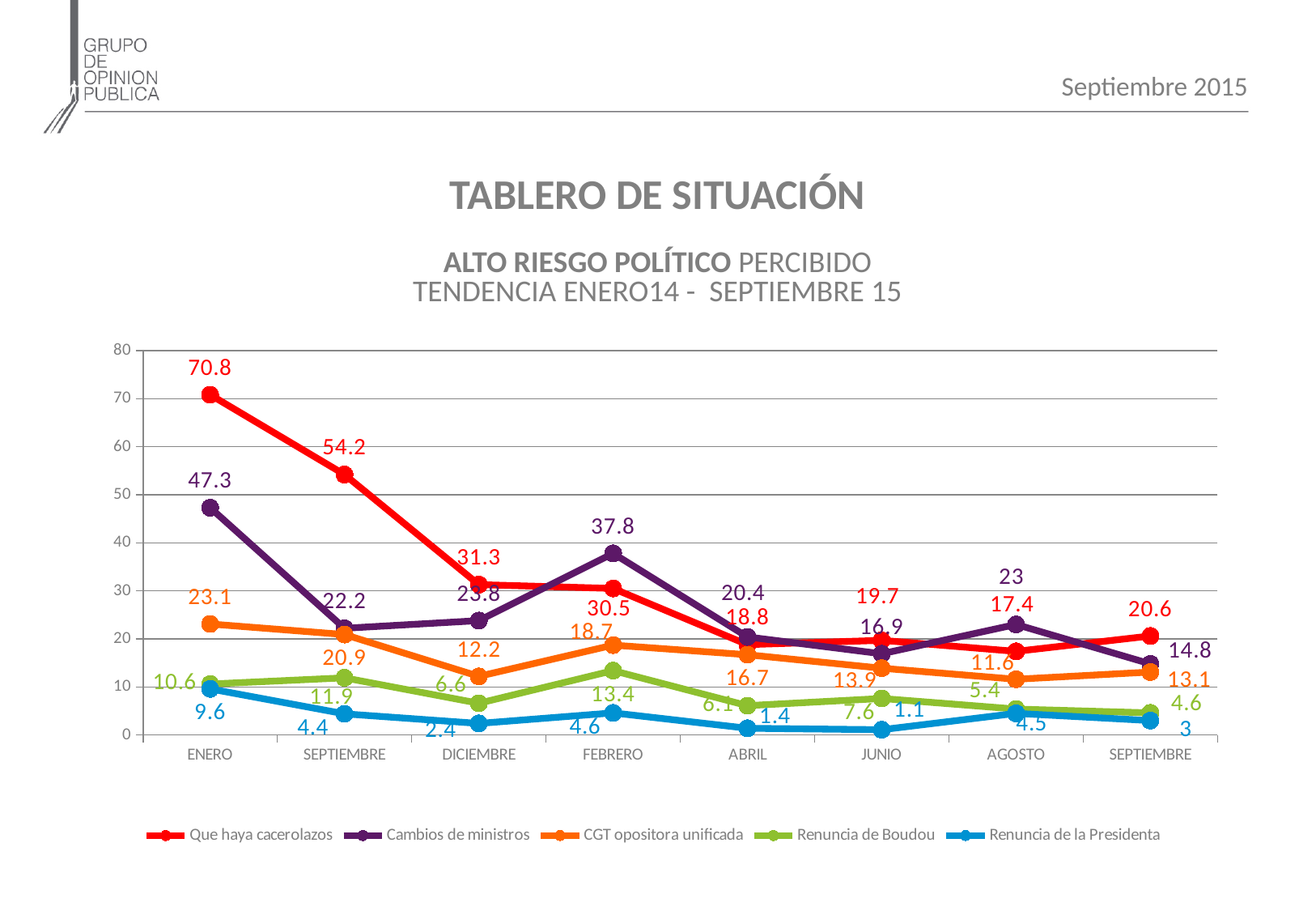
What is the value for Renuncia de Boudou at ABRIL? 6.1 What is the value for Cambios de ministros at FEBRERO? 37.8 At FEBRERO, which is larger: Cambios de ministros or Que haya cacerolazos? Cambios de ministros At which x-axis category does Renuncia de la Presidenta reach its lowest value? JUNIO How many categories are shown on the x axis? 8 How many series does the legend list? 5 Does the Que haya cacerolazos line rise or fall from ENERO to DICIEMBRE? Fall What kind of chart is shown on the slide? Line chart What is the value for Renuncia de la Presidenta at JUNIO? 1.1 At which x-axis category does Que haya cacerolazos reach its highest value? ENERO What is the value for Que haya cacerolazos at ENERO? 70.8 What is the difference between the Que haya cacerolazos values at ENERO and DICIEMBRE? 39.5